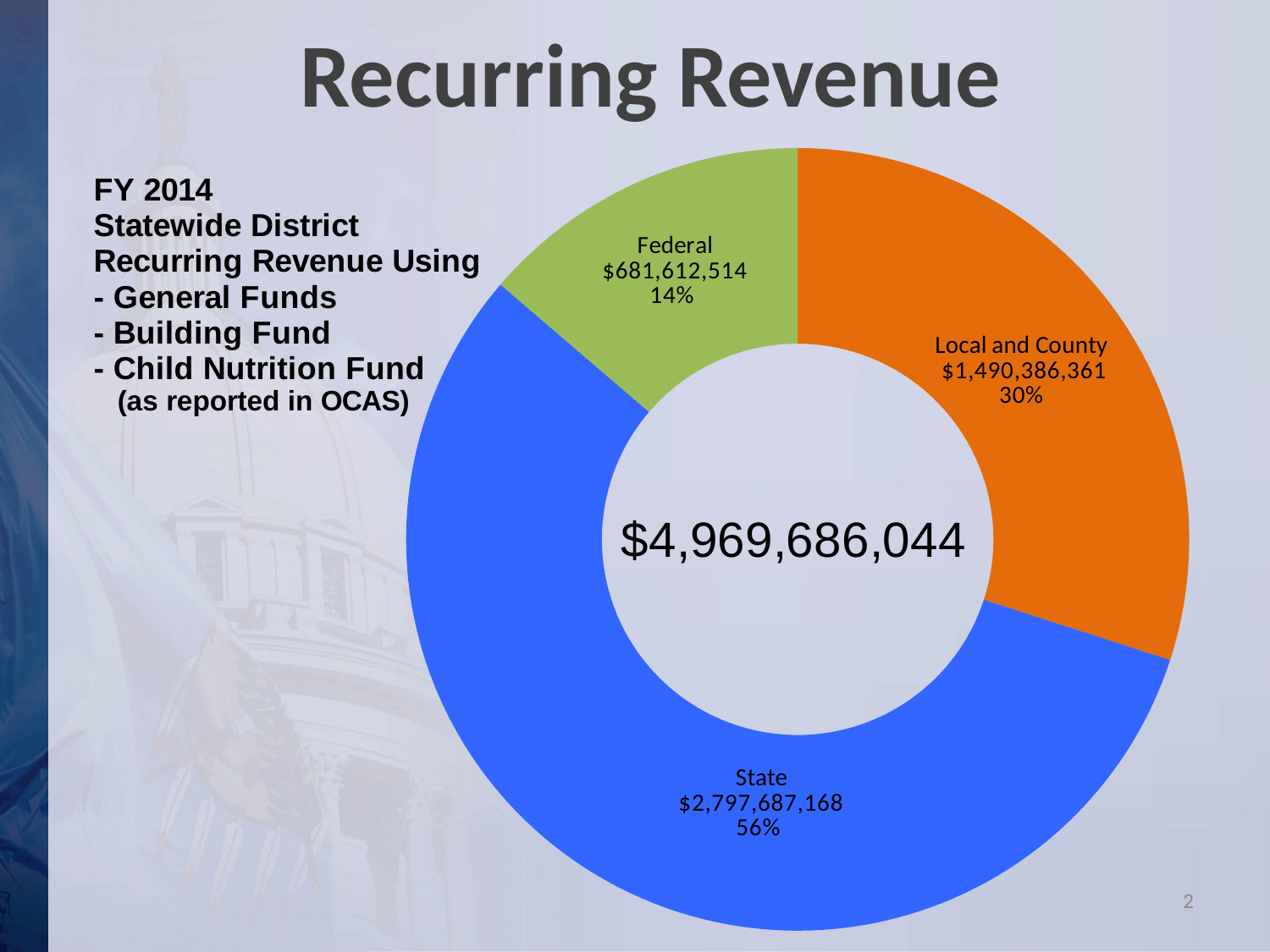
Which category has the largest share of the chart? State What percentage share does Federal have? 14% What kind of chart is shown on the slide? Doughnut (pie) chart Which is larger, Local and County or Federal? Local and County How many categories are shown in the chart? 3 What is the value for Federal? $681,612,514 What percentage share does Local and County have? 30% What total value is shown in the centre of the chart? $4,969,686,044 Which category has the smallest share of the chart? Federal What is the difference between the State value and the Local and County value? $1,307,300,807 What is the value for Local and County? $1,490,386,361 What is the value for State? $2,797,687,168